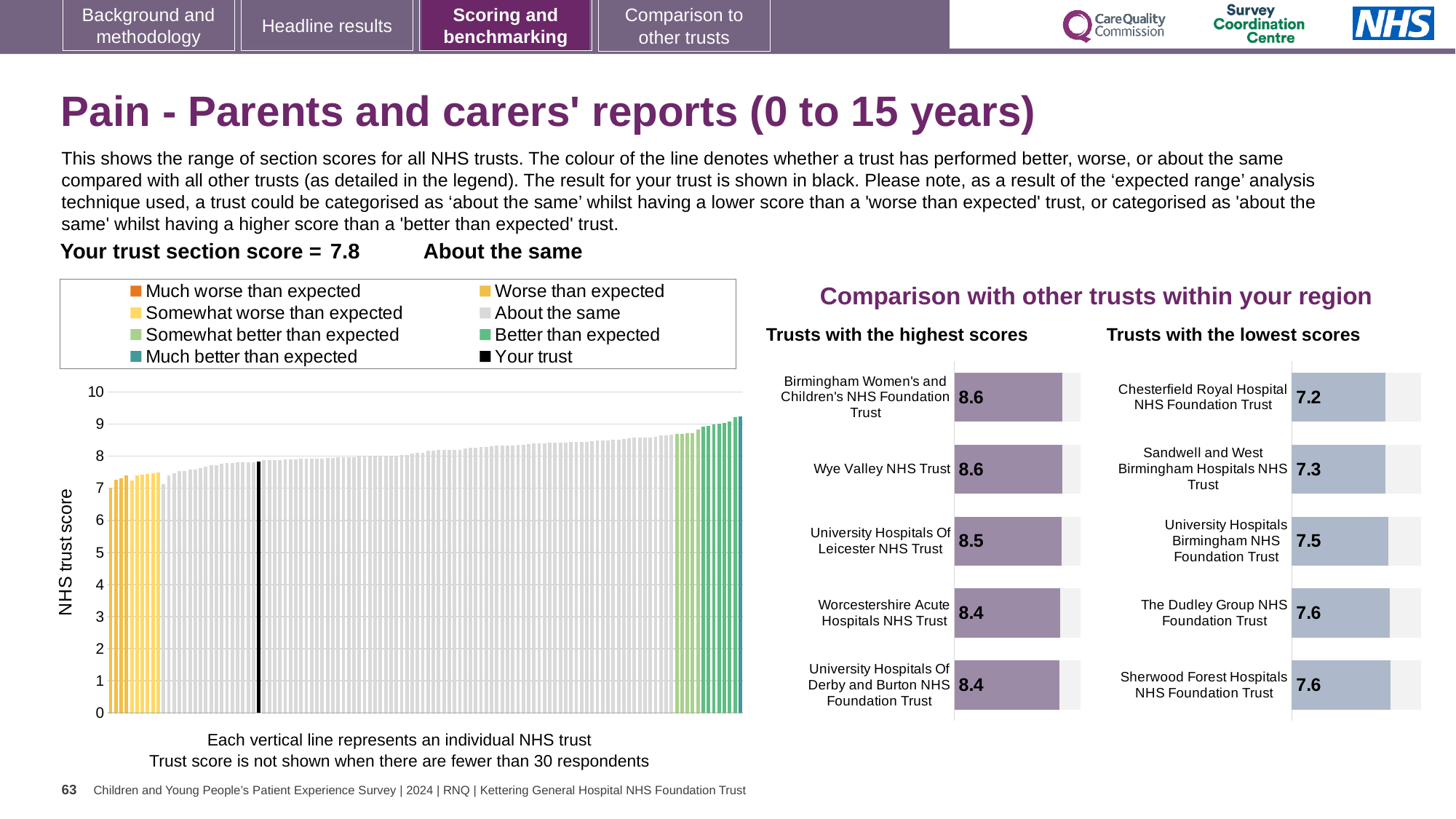
On the large chart on the left, do the trust scores rise or fall from left to right along the x axis? Rise On the 'Trusts with the lowest scores' chart, what is the score for Chesterfield Royal Hospital NHS Foundation Trust? 7.2 On the 'Trusts with the lowest scores' chart, how many trusts are shown? 5 How many entries does the legend of the large chart on the left list? 8 On the 'Trusts with the highest scores' chart, which is larger: the score for University Hospitals Of Leicester NHS Trust or Worcestershire Acute Hospitals NHS Trust? University Hospitals Of Leicester NHS Trust On the 'Trusts with the highest scores' chart, what is the score for University Hospitals Of Leicester NHS Trust? 8.5 On the 'Trusts with the highest scores' chart, what is the score for Wye Valley NHS Trust? 8.6 On the 'Trusts with the lowest scores' chart, what is the difference between the scores of The Dudley Group NHS Foundation Trust and Chesterfield Royal Hospital NHS Foundation Trust? 0.4 What kind of chart is the large chart on the left showing the range of section scores for all NHS trusts? Bar chart What is the y-axis label of the large chart on the left? NHS trust score On the 'Trusts with the lowest scores' chart, which trust has the lowest score? Chesterfield Royal Hospital NHS Foundation Trust On the 'Trusts with the highest scores' chart, how many trusts are shown? 5